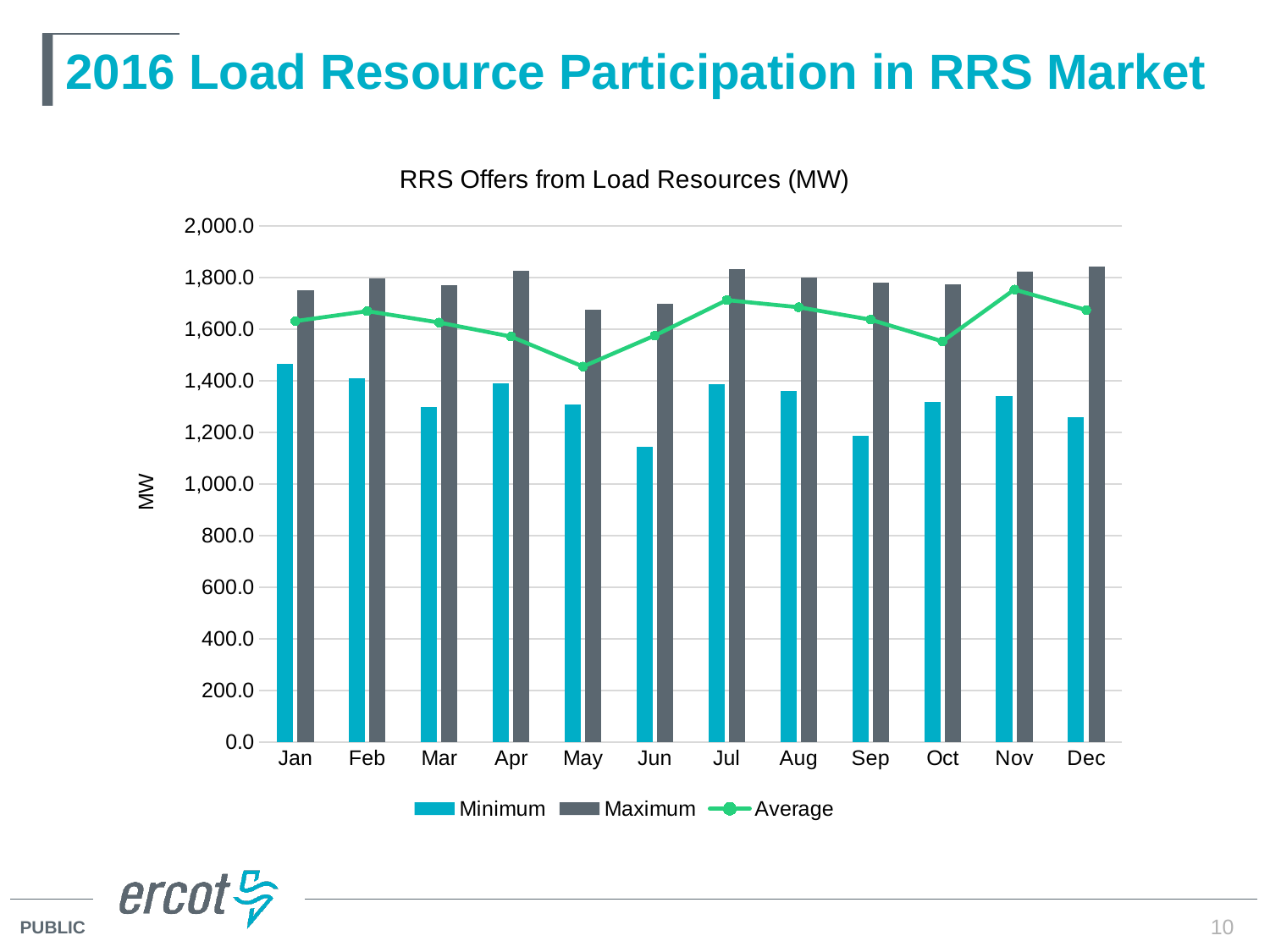
What is the title of the chart? RRS Offers from Load Resources (MW) Is the Average value for May greater or less than 1,600.0? less How many months are shown on the x axis? 12 Which month has the highest Minimum value? Jan Which is larger, the Average value for Jul or the Average value for May? Jul Is the Minimum value for Jan greater or less than 1,400.0? greater Which month has the lowest Average value? May What kind of chart is shown on the slide? A bar chart combined with a line Is the Maximum value for Dec greater or less than 1,800.0? greater Which month has the lowest Minimum value? Jun How many series does the legend list? 3